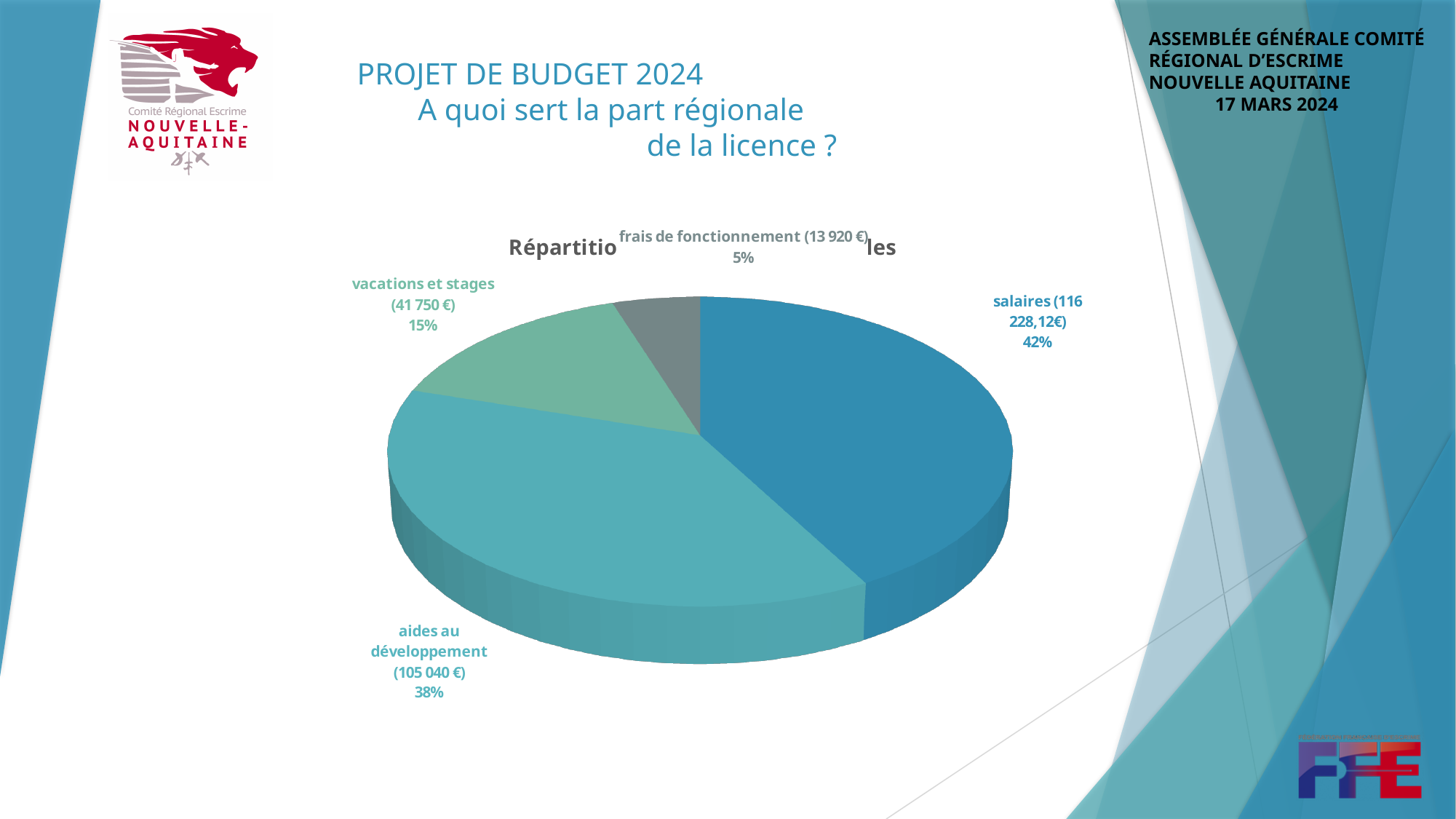
What amount in euros is shown for "vacations et stages"? 41 750 € Which is larger, the share for "vacations et stages" or the share for "frais de fonctionnement"? vacations et stages What percentage is shown for "vacations et stages"? 15% Which category has the smallest slice of the pie? frais de fonctionnement What share of the pie does the "aides au développement" slice represent? 38% What is the difference in percentage points between "salaires" and "aides au développement"? 4 What amount in euros is shown for "aides au développement"? 105 040 € What share of the pie does the "salaires" slice represent? 42% How many slices does the pie chart have? 4 What percentage is shown for "frais de fonctionnement"? 5% What amount in euros is shown for "frais de fonctionnement"? 13 920 € Which category has the largest slice of the pie? salaires